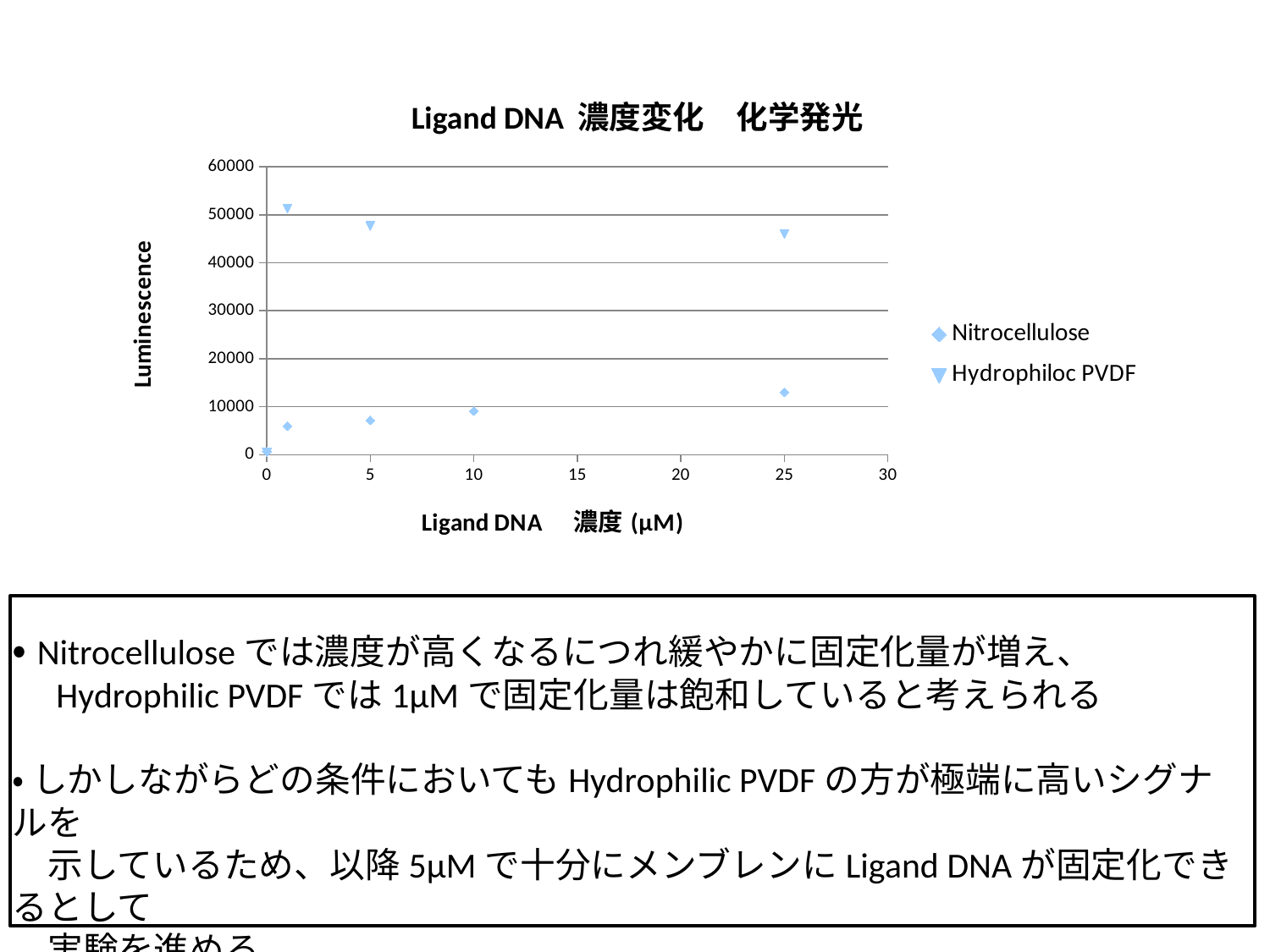
Is the Hydrophiloc PVDF value at 1 µM greater or less than 50000? greater What are the two series named in the legend? Nitrocellulose and Hydrophiloc PVDF At which Ligand DNA concentration does the Hydrophiloc PVDF series reach its highest luminescence? 1 At 5 µM, which series has the higher luminescence, Nitrocellulose or Hydrophiloc PVDF? Hydrophiloc PVDF How many series does the legend list? 2 What is the label of the y axis? Luminescence How many data points are plotted for the Nitrocellulose series? 5 Is the Nitrocellulose value at 25 µM greater or less than 20000? less What kind of chart is shown on the slide? scatter chart Does the Nitrocellulose luminescence rise or fall as the Ligand DNA concentration increases? rise Is the Hydrophiloc PVDF value at 25 µM greater or less than 40000? greater